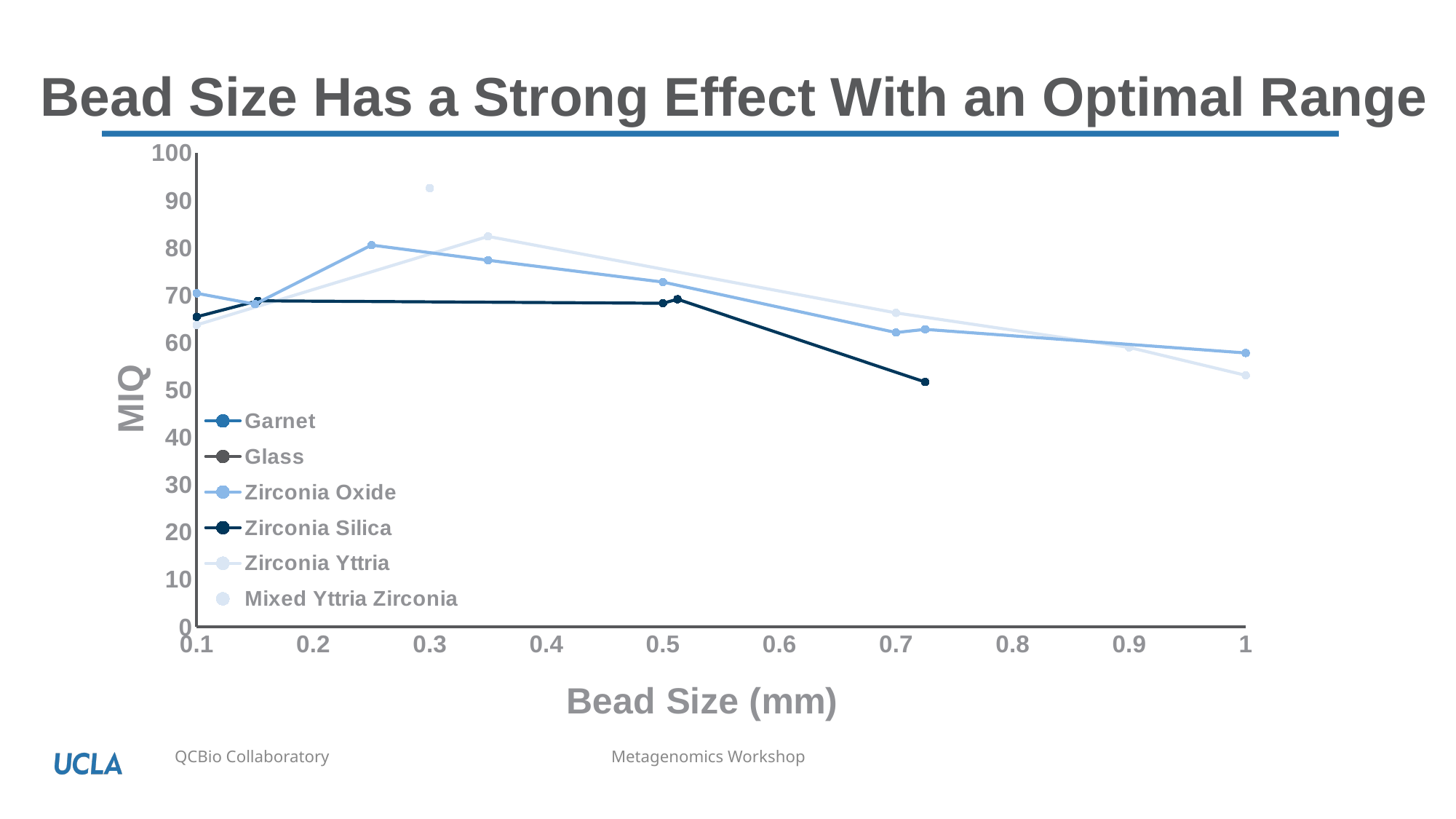
Does the Zirconia Oxide line rise or fall as bead size increases from 0.25 to 1 mm? fall Is the MIQ value for Zirconia Yttria at bead size 1 greater or less than 60? less What kind of chart is shown on the slide? line chart Is the MIQ value for Zirconia Oxide at bead size 0.5 greater or less than 70? greater Is the MIQ value for Mixed Yttria Zirconia at bead size 0.3 greater or less than 90? greater At bead size 1 mm, which series has the higher MIQ, Zirconia Oxide or Zirconia Yttria? Zirconia Oxide What is the title of the chart? Bead Size Has a Strong Effect With an Optimal Range How many data points are plotted for Mixed Yttria Zirconia? 1 How many series does the legend list? 6 Which series has the single highest MIQ point on the chart? Mixed Yttria Zirconia What is the label of the x axis? Bead Size (mm)